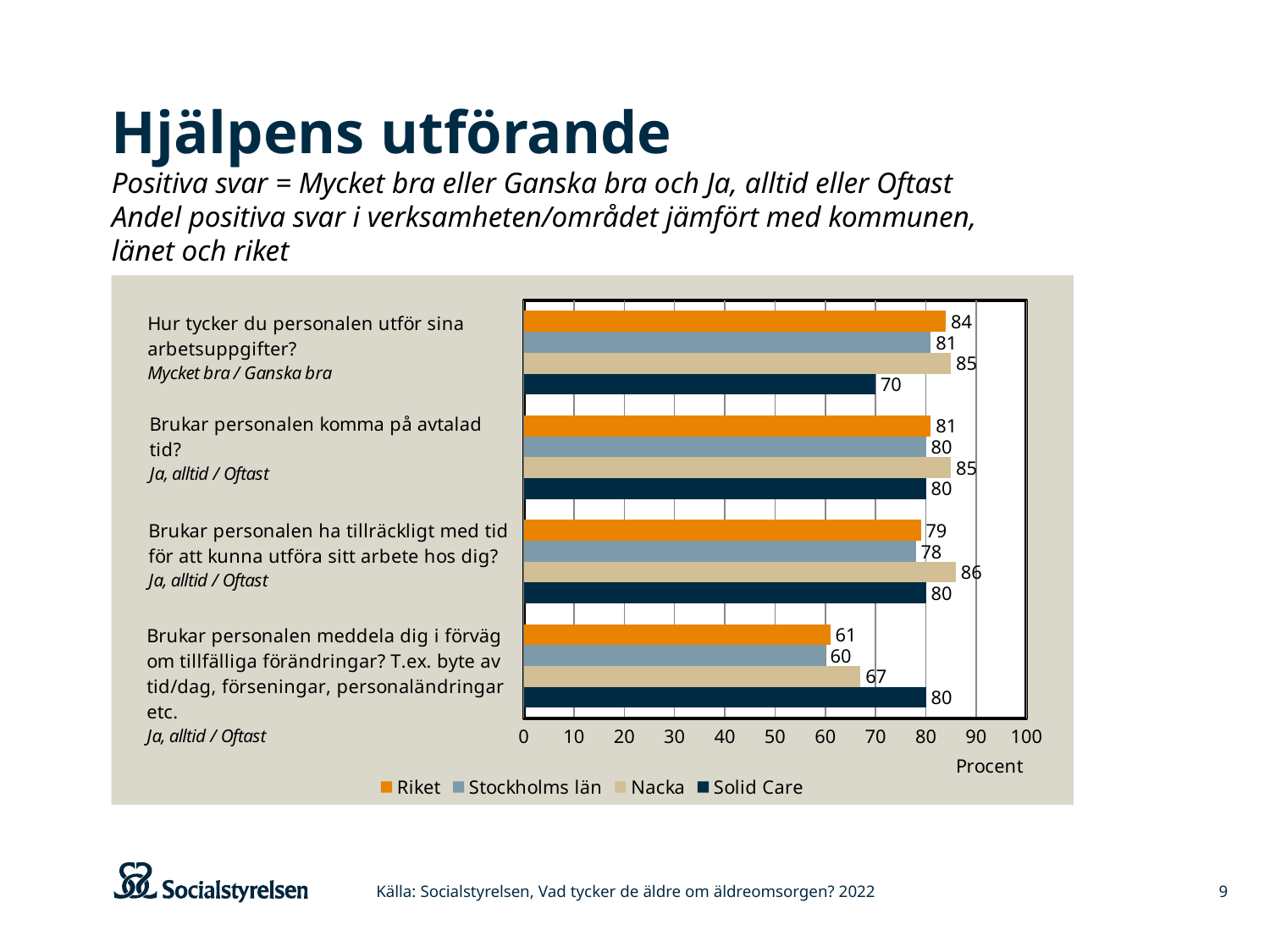
What is the value for Stockholms län on the question "Brukar personalen meddela dig i förväg om tillfälliga förändringar?"? 60 Which series has the lowest value on the question "Hur tycker du personalen utför sina arbetsuppgifter?"? Solid Care How many series does the legend list? 4 Which series has the highest value on the question "Brukar personalen meddela dig i förväg om tillfälliga förändringar?"? Solid Care On the question "Hur tycker du personalen utför sina arbetsuppgifter?", which is larger: Nacka or Solid Care? Nacka What is the value for Solid Care on the question "Hur tycker du personalen utför sina arbetsuppgifter?"? 70 What kind of chart is shown on the slide? Bar chart How many question categories are shown on the chart? 4 What is the value for Nacka on the question "Brukar personalen ha tillräckligt med tid för att kunna utföra sitt arbete hos dig?"? 86 What is the value for Riket on the question "Brukar personalen komma på avtalad tid?"? 81 What is the label on the horizontal axis of the chart? Procent What is the difference between Solid Care and Riket on the question "Brukar personalen meddela dig i förväg om tillfälliga förändringar?"? 19